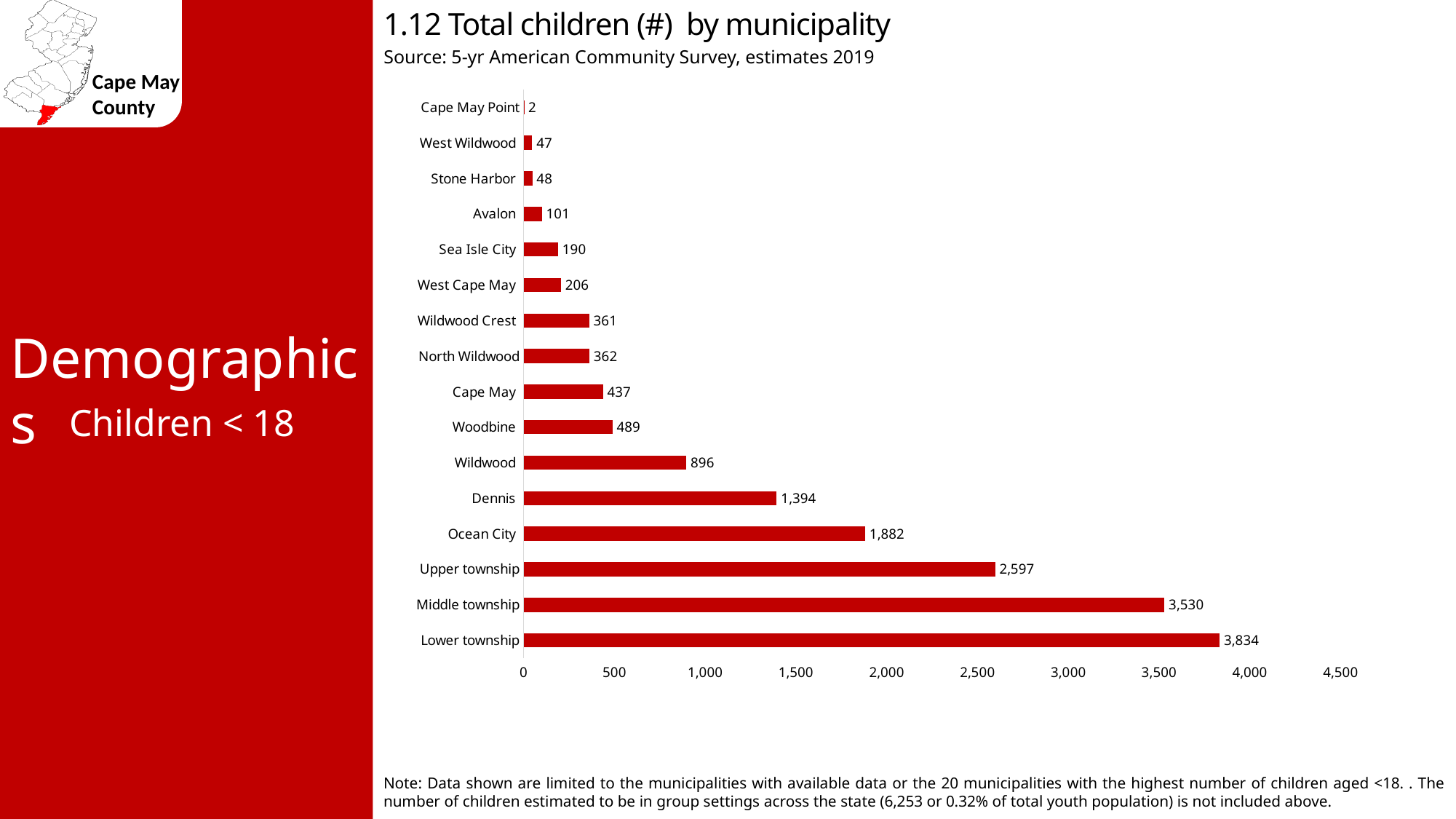
Is the value for Woodbine greater or less than 500? less What is the source of the data shown in the chart? 5-yr American Community Survey, estimates 2019 What is the difference in the number of children between Cape May and Woodbine? 52 What is the total number of children for Wildwood? 896 What is the total number of children for Sea Isle City? 190 Which has more children, Ocean City or Dennis? Ocean City Which municipality has the highest number of children? Lower township Which municipality has the lowest number of children? Cape May Point How many municipalities are shown in the chart? 16 What is the total number of children for Lower township? 3,834 What kind of chart is shown on the slide? bar chart What is the difference in the number of children between Middle township and Upper township? 933